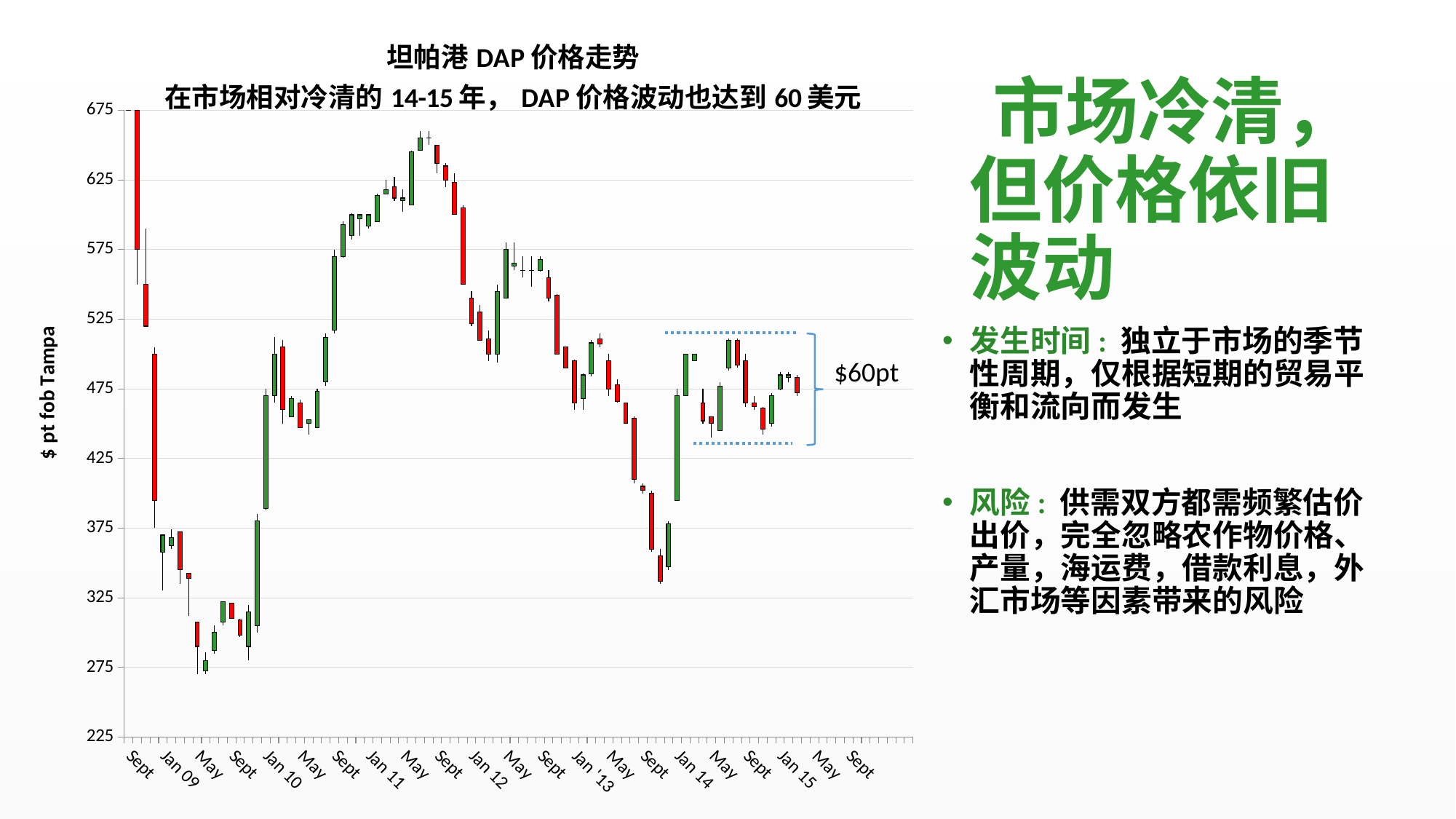
Which period has the higher DAP price: around May 2011 or around May 2009? May 2011 What is the label on the vertical axis of the chart? $ pt fob Tampa Does the DAP price generally rise or fall between Jan 10 and Sept 11? rise What is the title of the chart? 坦帕港 DAP 价格走势 What price range is annotated next to the bracket on the right side of the chart for 2014-15? $60pt Is the DAP price around May 2009 greater or less than 325? less What is the lowest value shown on the vertical axis? 225 What kind of chart is shown on the slide? Candlestick (stock) chart What is the highest value shown on the vertical axis? 675 Does the DAP price generally rise or fall between Sept 11 and Sept 13? fall